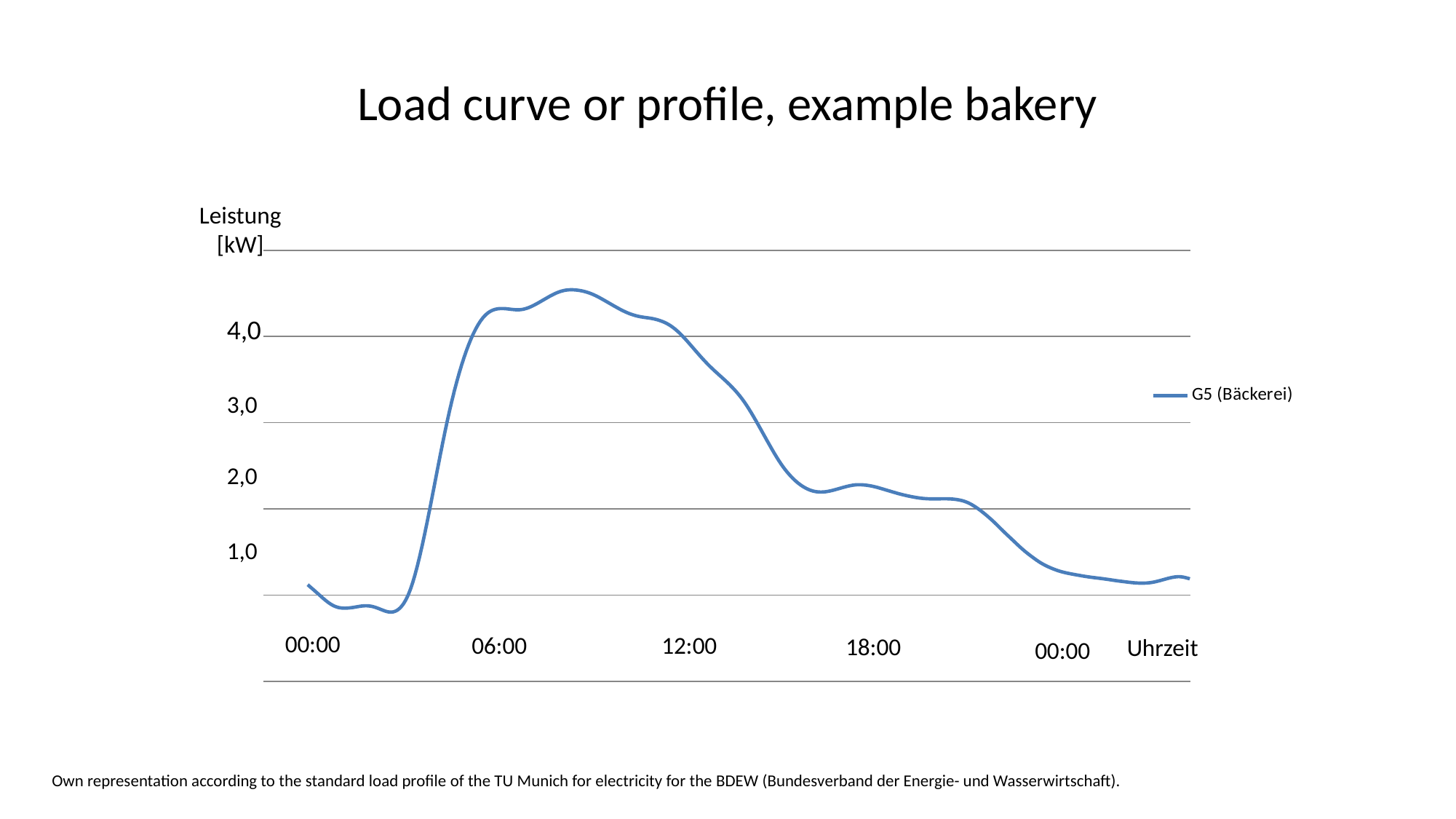
Does the G5 (Bäckerei) curve rise or fall between 12:00 and 18:00? fall Which is larger for G5 (Bäckerei): the value at 06:00 or the value at 18:00? 06:00 What is the title of the chart on the slide? Load curve or profile, example bakery Does the G5 (Bäckerei) curve rise or fall between 00:00 and 06:00? rise What kind of chart is shown on the slide? line chart Is the highest value of the G5 (Bäckerei) curve greater or less than 4,0? greater Is the lowest value of the G5 (Bäckerei) curve greater or less than 1,0? less Is the value for G5 (Bäckerei) at 18:00 greater or less than 3,0? less What is the name of the series shown in the legend? G5 (Bäckerei) How many series does the legend list? 1